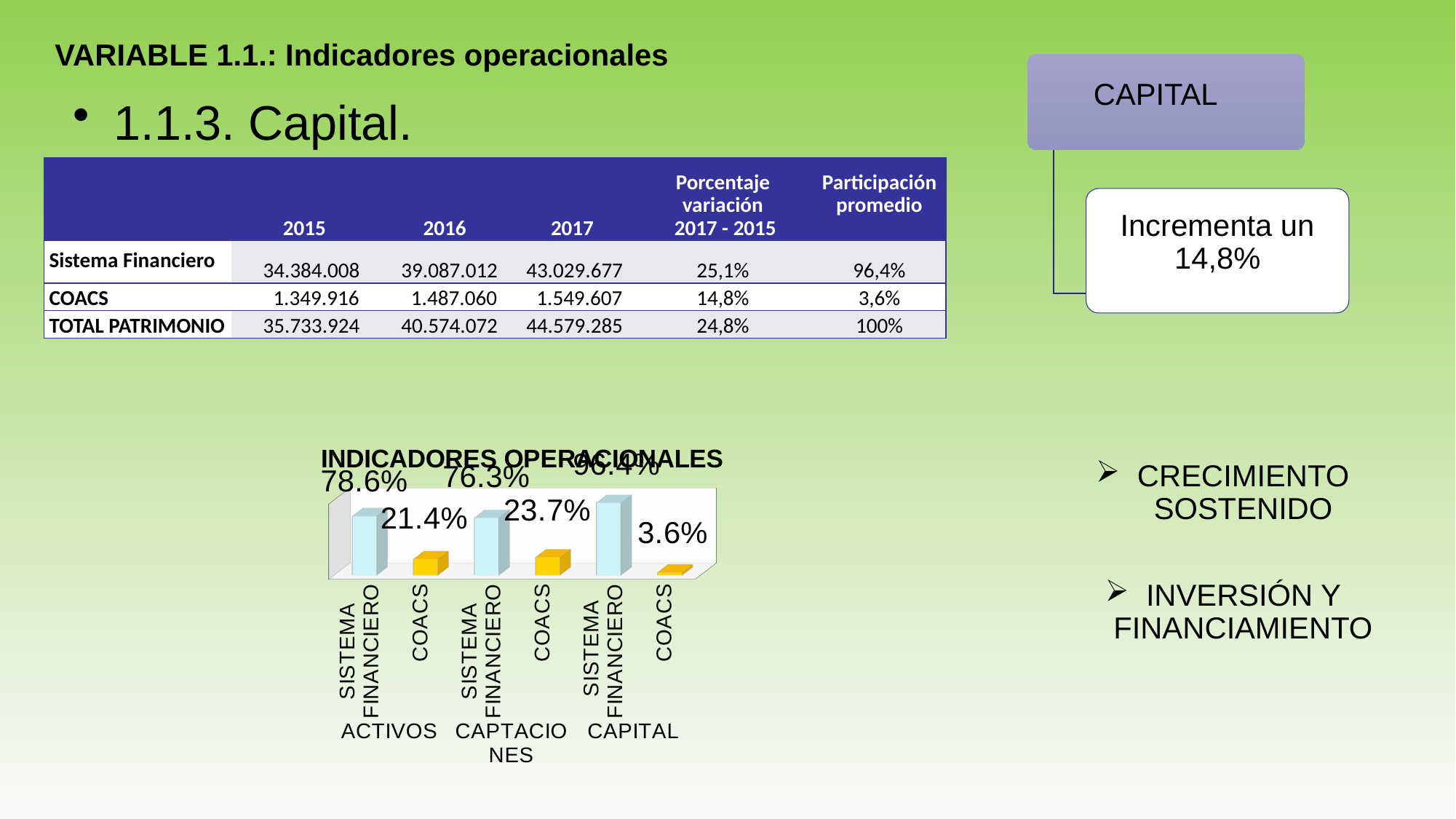
In the INDICADORES OPERACIONALES chart, what is the value for SISTEMA FINANCIERO under ACTIVOS? 78.6% In the INDICADORES OPERACIONALES chart, which bar has the highest value? SISTEMA FINANCIERO under CAPITAL In the INDICADORES OPERACIONALES chart, what is the value for COACS under CAPTACIONES? 23.7% What is the title of the chart on the slide? INDICADORES OPERACIONALES In the INDICADORES OPERACIONALES chart, which bar has the lowest value? COACS under CAPITAL How many bars are plotted in the INDICADORES OPERACIONALES chart? 6 What kind of chart is shown under the title INDICADORES OPERACIONALES? bar chart In the INDICADORES OPERACIONALES chart, what is the difference between the SISTEMA FINANCIERO and COACS values under CAPITAL? 92.8% In the INDICADORES OPERACIONALES chart, what is the value for COACS under CAPITAL? 3.6% In the INDICADORES OPERACIONALES chart, what is the value for SISTEMA FINANCIERO under CAPITAL? 96.4% In the INDICADORES OPERACIONALES chart, what is the value for COACS under ACTIVOS? 21.4% In the INDICADORES OPERACIONALES chart, what is the value for SISTEMA FINANCIERO under CAPTACIONES? 76.3%